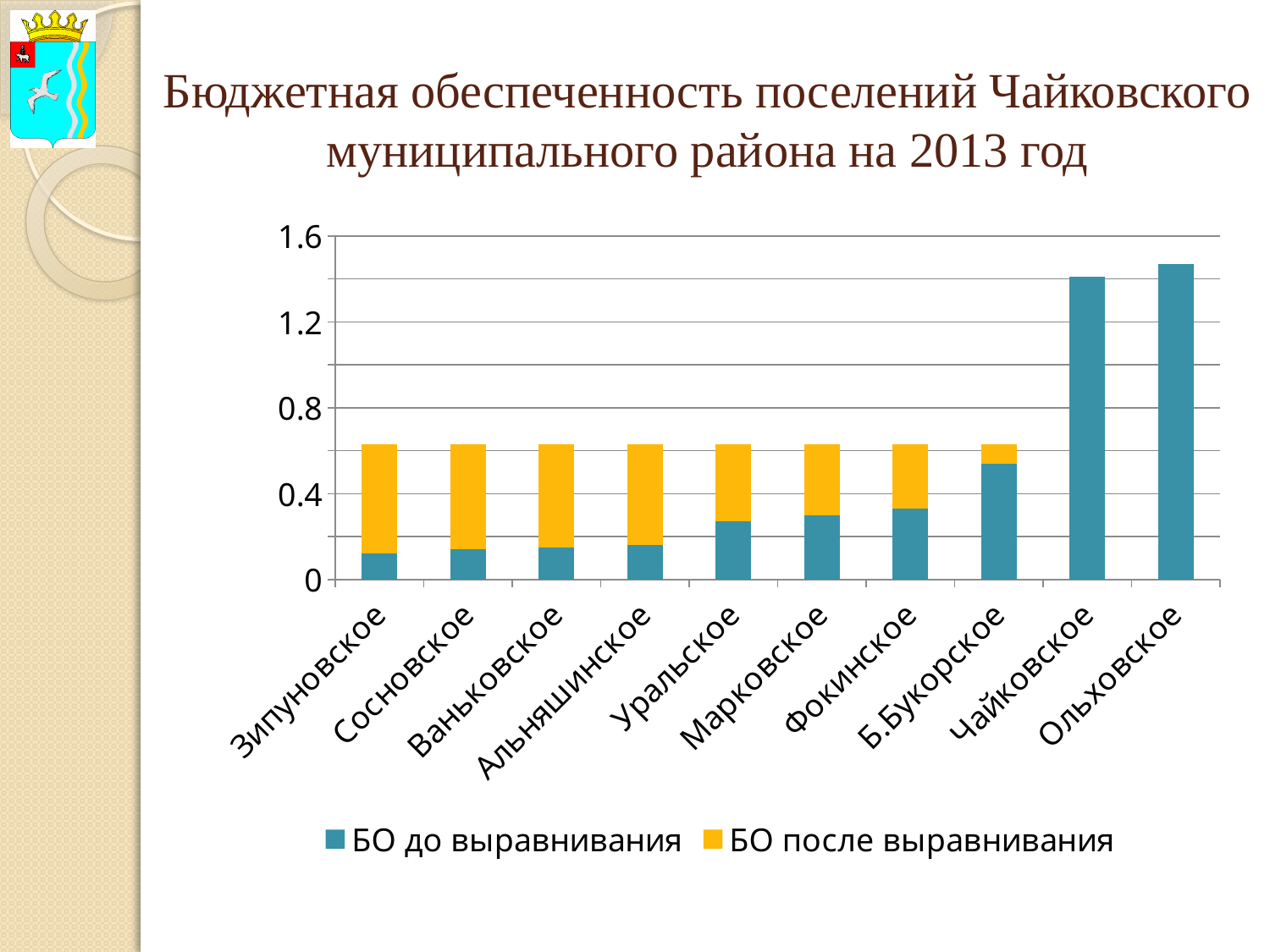
What colour represents the 'БО после выравнивания' series in the chart? yellow Is the 'БО до выравнивания' value for Б.Букорское greater or less than 0.4? greater Is the 'БО до выравнивания' value for Чайковское greater or less than 1.2? greater How many series does the chart legend list? 2 What kind of chart is shown on the slide? bar chart Is the 'БО до выравнивания' value for Зипуновское greater or less than 0.4? less How many settlements (categories) are shown on the x axis of the chart? 10 Do the 'БО до выравнивания' values rise or fall from left to right along the x axis? rise Which has the larger 'БО до выравнивания' value, Зипуновское or Уральское? Уральское Which settlement has the highest value for 'БО до выравнивания'? Ольховское